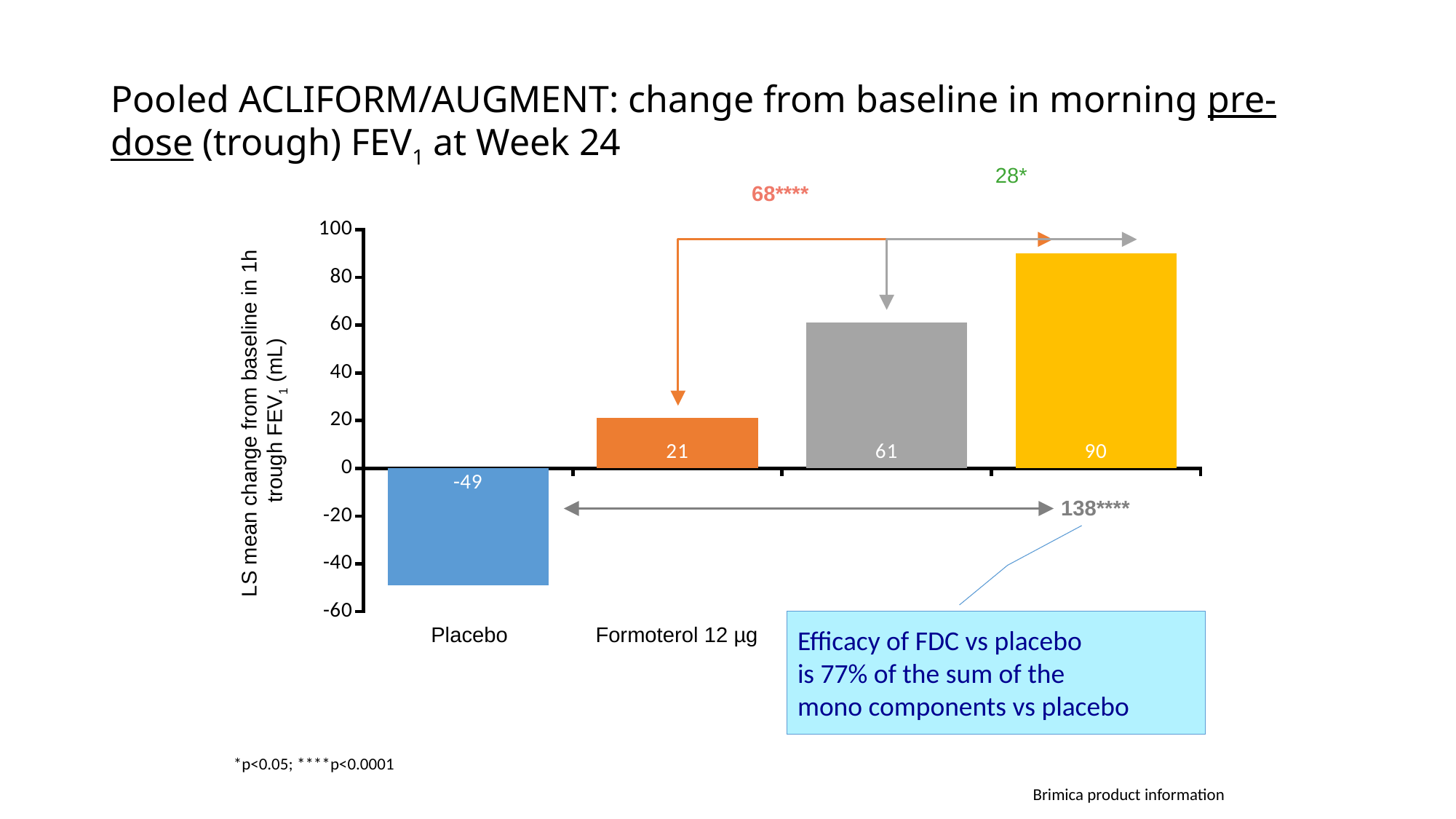
Do the bar values rise or fall from left to right along the x axis? Rise What is the value for Formoterol 12 µg? 21 What kind of chart is shown on the slide? Bar chart What is the value shown on the yellow bar? 90 Which category has the lowest value? Placebo What is the highest value plotted in the chart? 90 What difference is annotated on the arrow between the Placebo bar and the yellow bar? 138**** What is the value shown on the grey bar? 61 Which is larger, the value for Placebo or the value for Formoterol 12 µg? Formoterol 12 µg What is the difference between the values for Formoterol 12 µg and Placebo? 70 How many bars are plotted in the chart? 4 What is the value for Placebo? -49